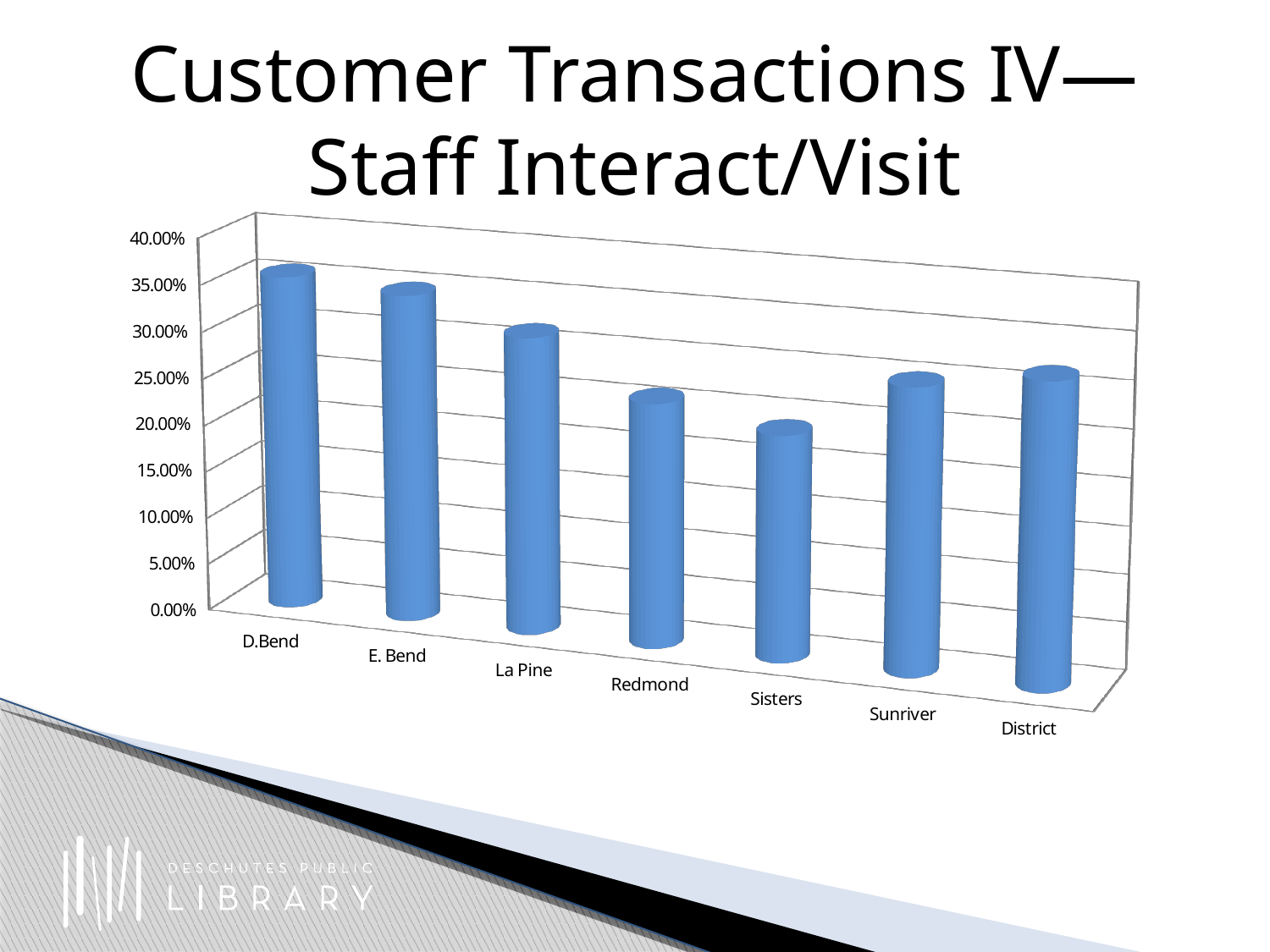
Which has the larger value, E. Bend or Sunriver? E. Bend What kind of chart is shown on the slide? bar chart Is the value for La Pine greater or less than 25.00%? greater Is the value for Sisters greater or less than 25.00%? less Is the value for Redmond greater or less than 30.00%? less Which category has the lowest value in the chart? Sisters Do the values rise or fall from D.Bend through Sisters along the x axis? fall What is the title of the slide containing the chart? Customer Transactions IV—Staff Interact/Visit Which category has the highest value in the chart? D.Bend How many categories are shown on the x axis of the chart? 7 Which has the larger value, La Pine or Redmond? La Pine